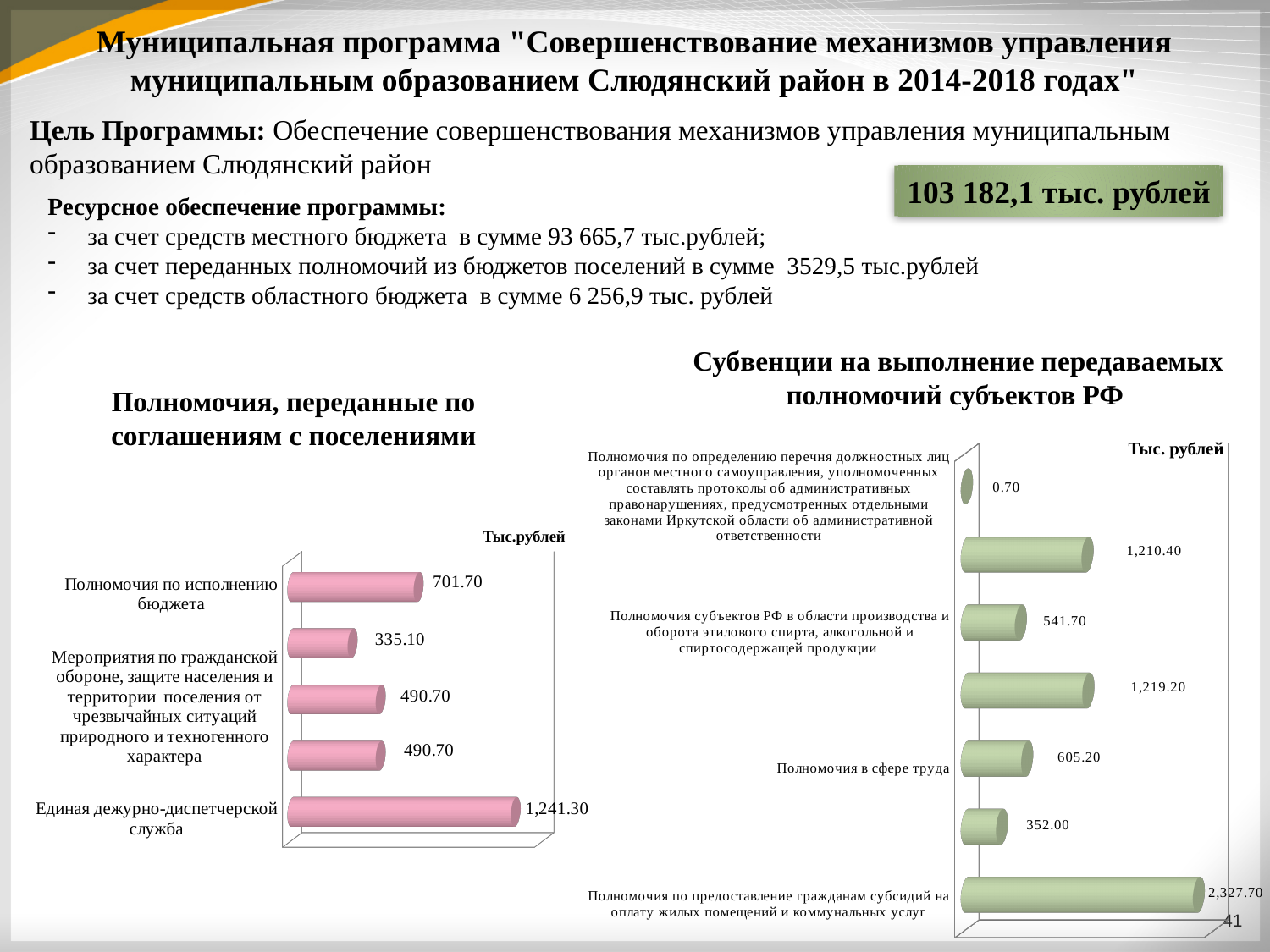
In the chart 'Субвенции на выполнение передаваемых полномочий субъектов РФ', what is the value for 'Полномочия по предоставление гражданам субсидий на оплату жилых помещений и коммунальных услуг'? 2,327.70 What type of chart is 'Субвенции на выполнение передаваемых полномочий субъектов РФ'? Bar chart In the chart 'Полномочия, переданные по соглашениям с поселениями', what is the value for 'Единая дежурно-диспетчерская служба'? 1,241.30 In the chart 'Полномочия, переданные по соглашениям с поселениями', what is the value for 'Полномочия по исполнению бюджета'? 701.70 In the chart 'Субвенции на выполнение передаваемых полномочий субъектов РФ', what is the smallest value shown? 0.70 In the chart 'Полномочия, переданные по соглашениям с поселениями', what is the smallest value shown? 335.10 In the chart 'Полномочия, переданные по соглашениям с поселениями', what is the difference between 'Единая дежурно-диспетчерская служба' and 'Полномочия по исполнению бюджета'? 539.60 In the chart 'Субвенции на выполнение передаваемых полномочий субъектов РФ', which is larger: the value for 'Полномочия в сфере труда' or the value for 'Полномочия субъектов РФ в области производства и оборота этилового спирта'? Полномочия в сфере труда In the chart 'Полномочия, переданные по соглашениям с поселениями', how many bars are plotted? 5 In the chart 'Субвенции на выполнение передаваемых полномочий субъектов РФ', how many bars are plotted? 7 In the chart 'Субвенции на выполнение передаваемых полномочий субъектов РФ', what is the value for 'Полномочия субъектов РФ в области производства и оборота этилового спирта, алкогольной и спиртосодержащей продукции'? 541.70 In the chart 'Полномочия, переданные по соглашениям с поселениями', which category has the highest value? Единая дежурно-диспетчерская служба